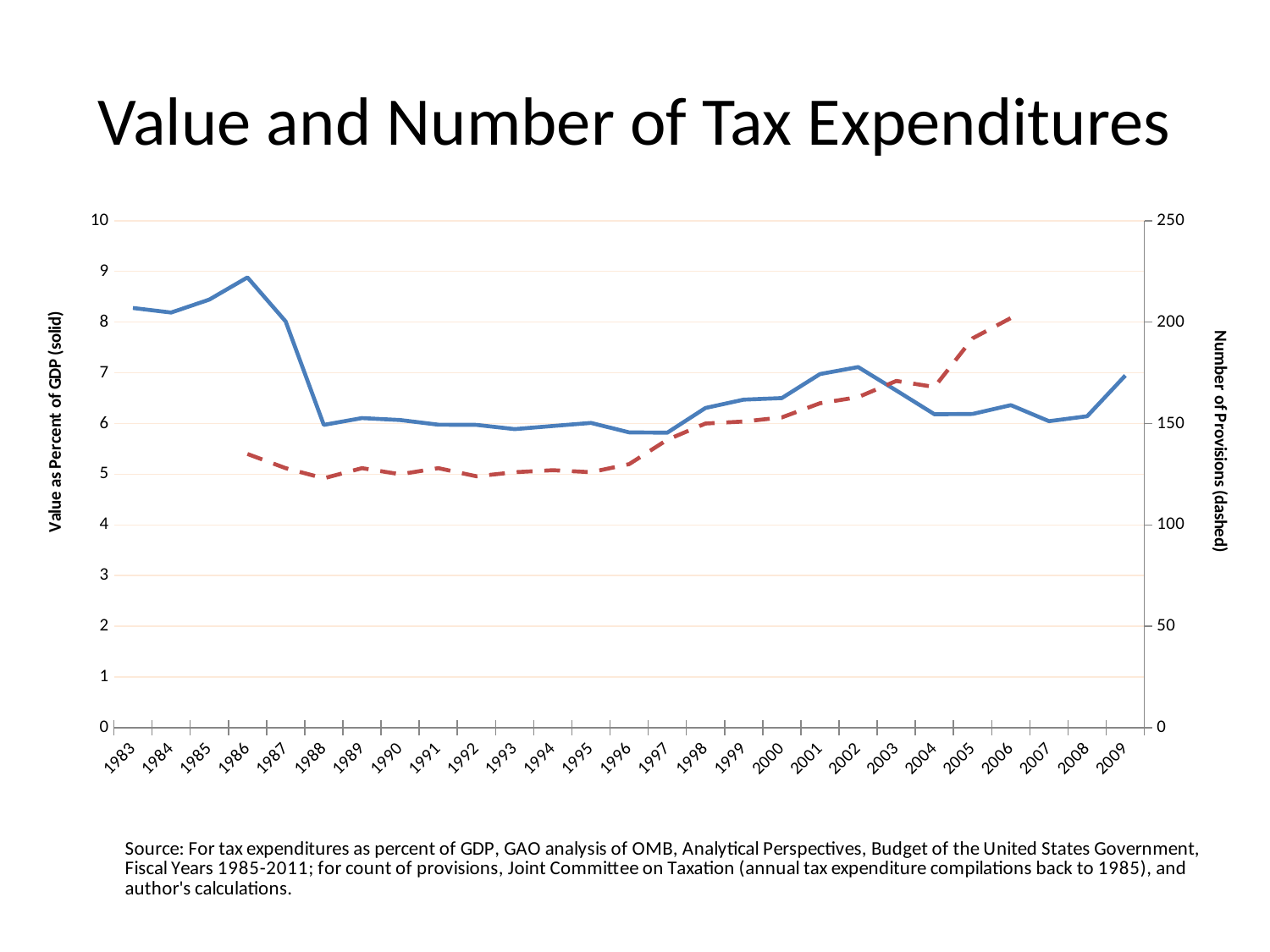
In which year does the solid line (Value as Percent of GDP) reach its highest point? 1986 Does the solid line rise or fall between 1986 and 1988? fall Is the dashed line's value for 2006 greater or less than 150? greater How many years are plotted along the x axis? 27 In which year does the dashed line (Number of Provisions) reach its highest point? 2006 What kind of chart is shown on the slide? line chart Is the solid line's value for 1988 greater or less than 7? less What is the title of the chart? Value and Number of Tax Expenditures Which year has the larger value on the solid line, 1983 or 1988? 1983 Which series is drawn with a dashed line, according to the axis titles? Number of Provisions Is the solid line's value for 1986 greater or less than 8? greater